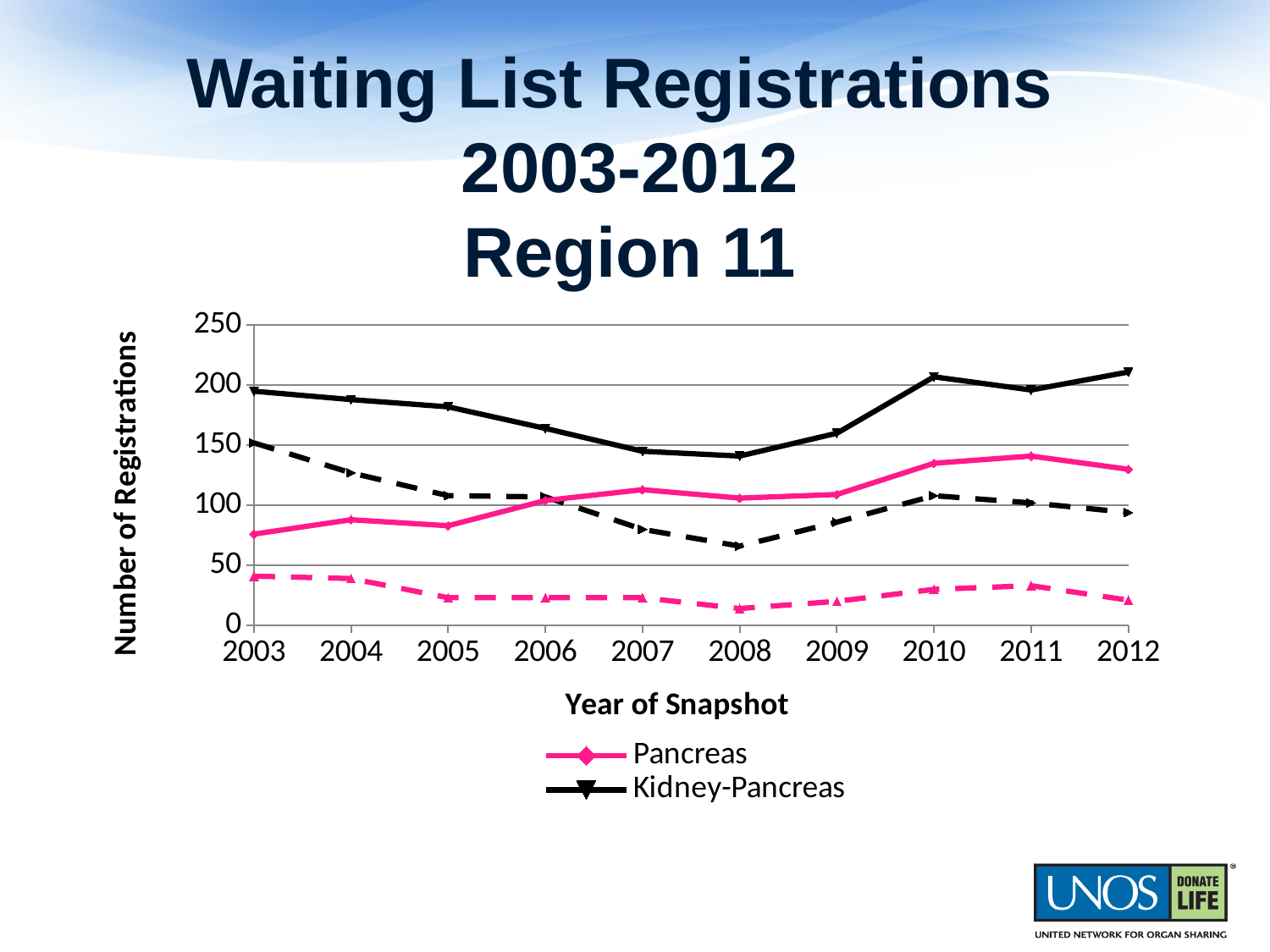
What is the title of the chart's x axis? Year of Snapshot Is the Kidney-Pancreas value for 2003 greater or less than 150? greater In 2012, which series has the larger value, Pancreas or Kidney-Pancreas? Kidney-Pancreas Does the Pancreas line rise or fall from 2008 to 2011? Rise Is the Pancreas value for 2011 greater or less than 100? greater What kind of chart is shown on the slide? Line chart How many series does the chart's legend list? 2 Is the Pancreas value for 2003 greater or less than 50? greater How many years are plotted along the x axis of the chart? 10 Does the Kidney-Pancreas line rise or fall from 2003 to 2008? Fall